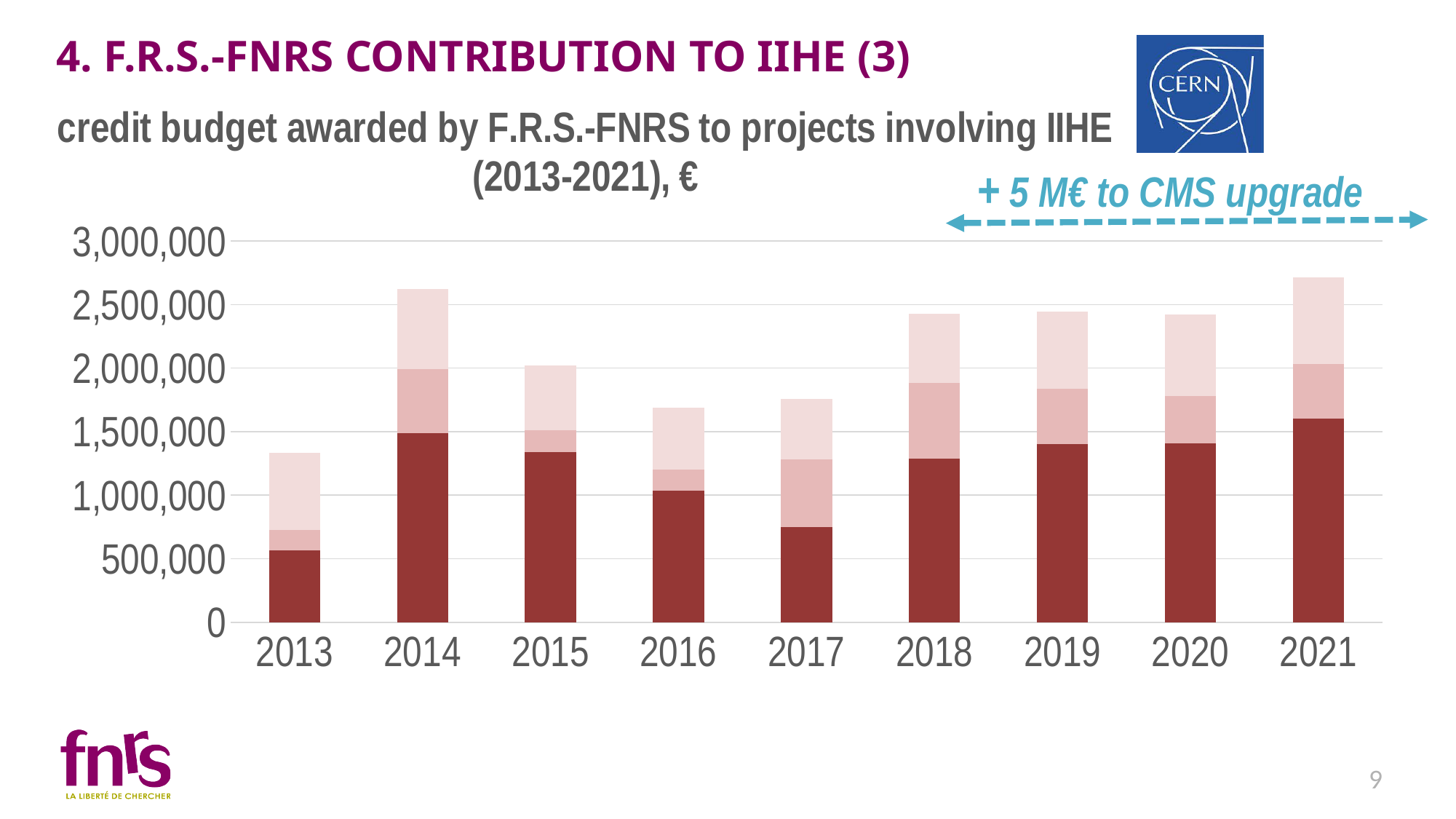
Which year has a larger total bar, 2014 or 2015? 2014 Is the total value for 2014 greater or less than 2,500,000? greater Is the dark red segment for 2017 greater or less than 1,000,000? less Is the total value for 2013 greater or less than 1,500,000? less How many years are shown on the x axis of the chart? 9 Which year has the lowest total bar in the chart? 2013 What kind of chart is shown on the slide? Stacked bar chart Which year has the highest total bar in the chart? 2021 Which year has a larger total bar, 2013 or 2016? 2016 What is the title of the chart? credit budget awarded by F.R.S.-FNRS to projects involving IIHE (2013-2021), €